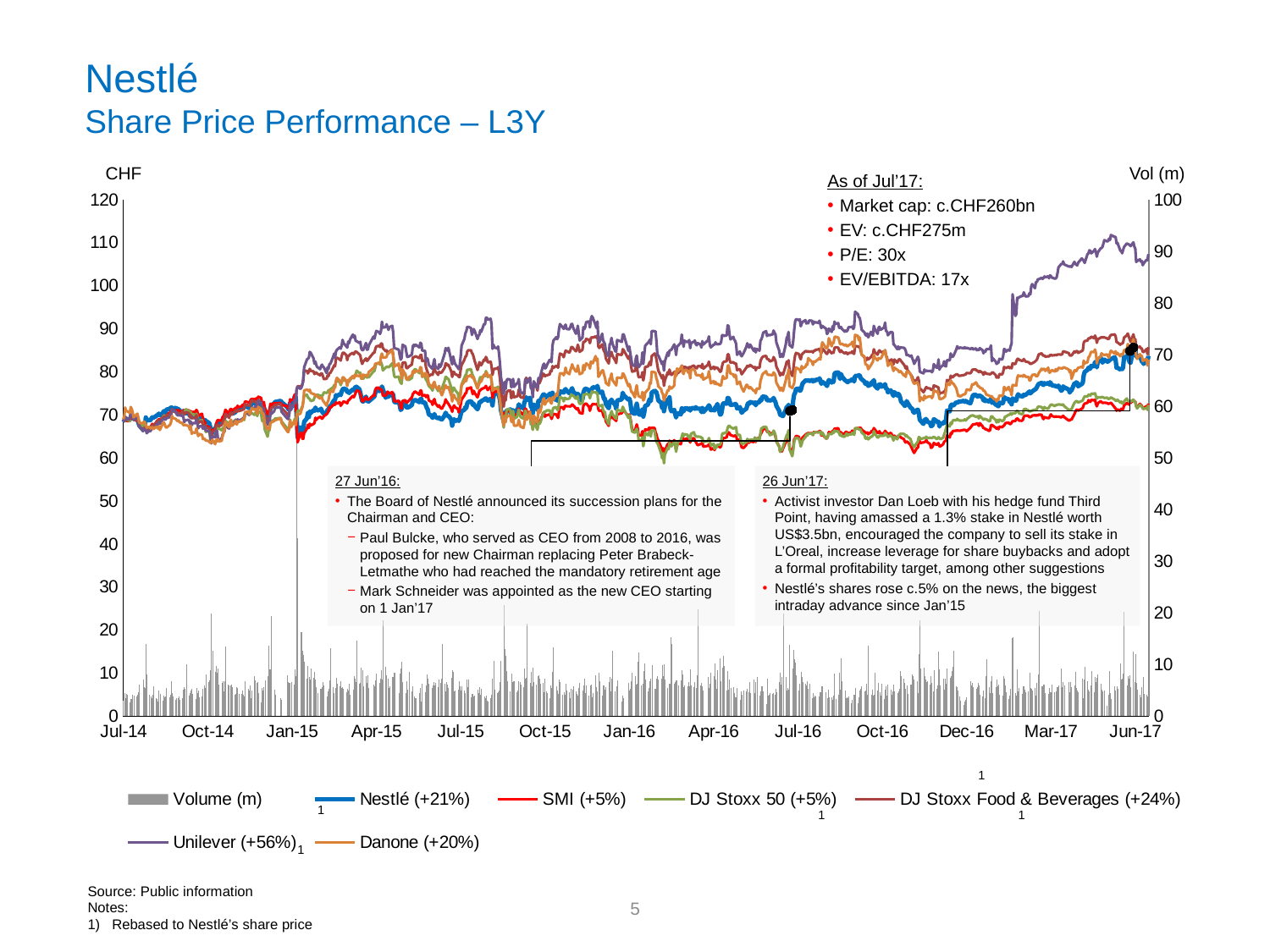
What percentage change does the legend show for Nestlé? +21% Which series in the legend shows the highest percentage change? Unilever (+56%) How many series does the legend list? 7 What percentage change does the legend show for Unilever? +56% Is the Nestlé line at Jun-17 greater or less than 80 on the CHF axis? greater What is the first date label on the x axis of the chart? Jul-14 Is the Unilever line at Jun-17 greater or less than 100 on the CHF axis? greater Which has the larger percentage change in the legend, Danone or DJ Stoxx 50? Danone What percentage change does the legend show for DJ Stoxx Food & Beverages? +24% What is the difference in percentage points between the legend's change for Nestlé and for SMI? 16 percentage points What unit is shown on the left vertical axis of the chart? CHF What kind of chart is shown on the slide? line chart